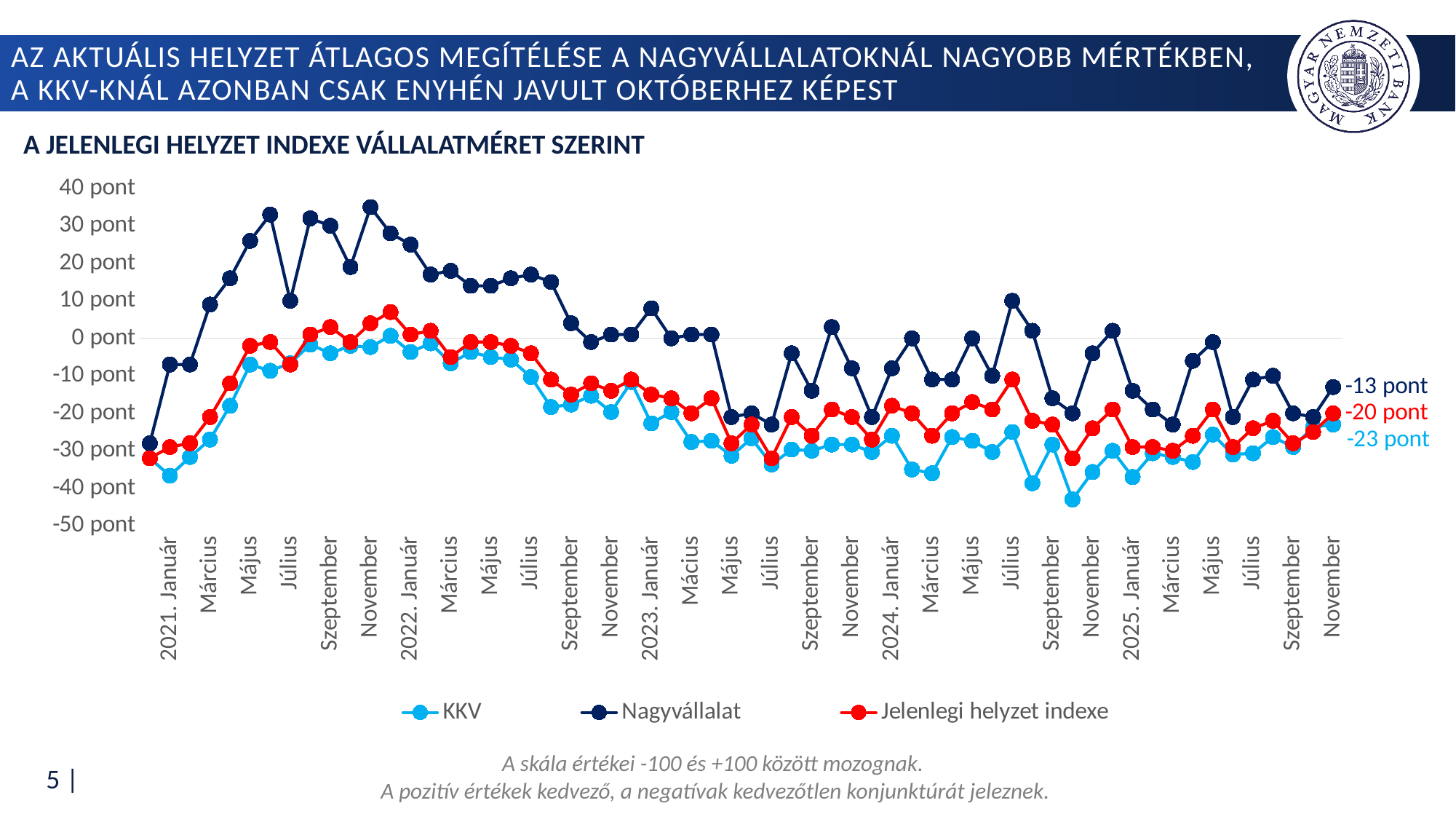
At the last point (2025 November), which series has the higher value: KKV or Nagyvállalat? Nagyvállalat Which series has the highest value at the last point (2025 November)? Nagyvállalat Is the value for KKV in 2021 Január greater or less than -30 pont? less How many series does the legend list? 3 What is the value of the Jelenlegi helyzet indexe series at the last point (2025 November)? -20 pont Is the value for Nagyvállalat in 2021 Május greater or less than 20 pont? greater What is the value of the Nagyvállalat series at the last point (2025 November)? -13 pont What kind of chart is shown on the slide? Line chart What is the title of the chart? A JELENLEGI HELYZET INDEXE VÁLLALATMÉRET SZERINT At the last point (2025 November), what is the difference between the Jelenlegi helyzet indexe value and the KKV value? 3 pont At the last point (2025 November), what is the difference between the Nagyvállalat value and the KKV value? 10 pont What is the value of the KKV series at the last point (2025 November)? -23 pont